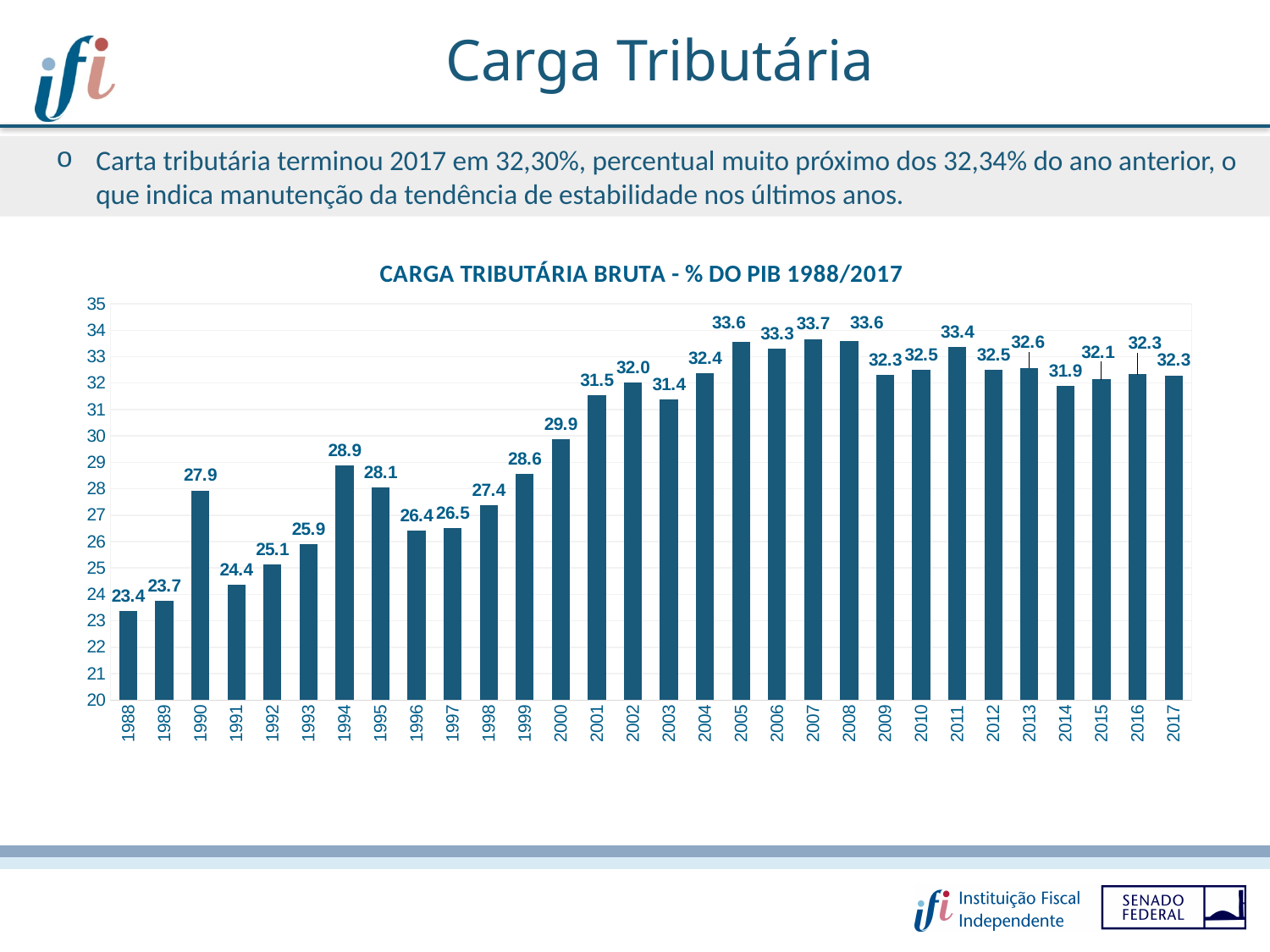
What is the value for 2000? 29.9 What is the title of the chart? CARGA TRIBUTÁRIA BRUTA - % DO PIB 1988/2017 What kind of chart is shown on the slide? bar chart What is the difference between the values for 1990 and 1991? 3.5 Which year has the lowest value? 1988 What is the value for 1994? 28.9 What is the difference between the values for 2007 and 1988? 10.3 Is the value for 1996 greater or less than 27? less What is the value for 2017 in the chart? 32.3 Which is larger, the value for 2005 or the value for 2011? 2005 How many years are shown on the x axis? 30 Which year has the highest value? 2007